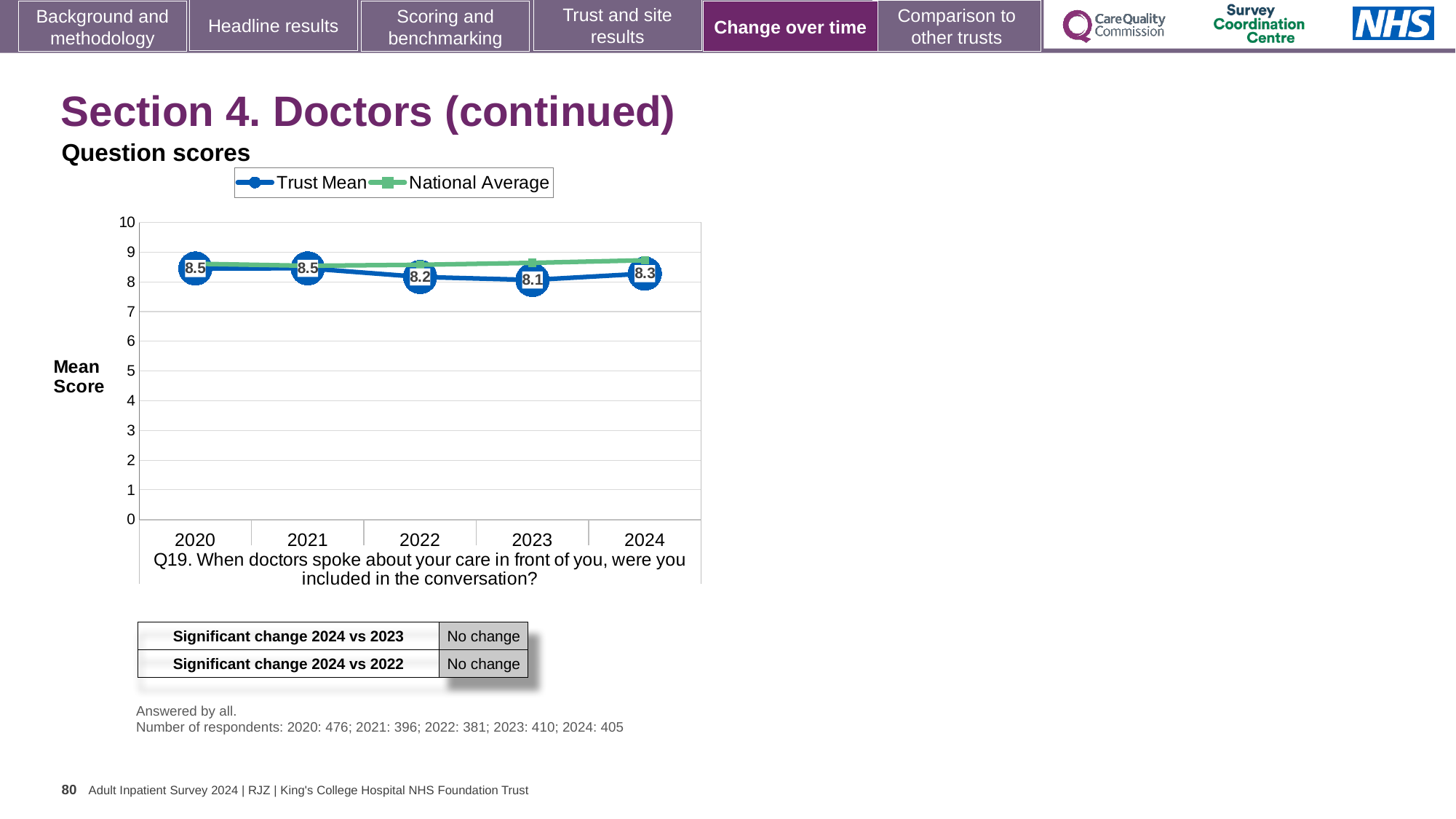
Which year has the larger Trust Mean, 2021 or 2023? 2021 What is the difference between the Trust Mean in 2020 and in 2024? 0.2 Is the National Average value for 2024 greater or less than 8? greater Does the Trust Mean rise or fall from 2021 to 2023? fall What is the Trust Mean value for 2020? 8.5 How many years are plotted on the x axis? 5 What is the Trust Mean value for 2022? 8.2 How many series does the legend list? 2 What kind of chart is shown? line chart What is the Trust Mean value for 2024? 8.3 In which year is the Trust Mean lowest? 2023 What is the Trust Mean value for 2023? 8.1